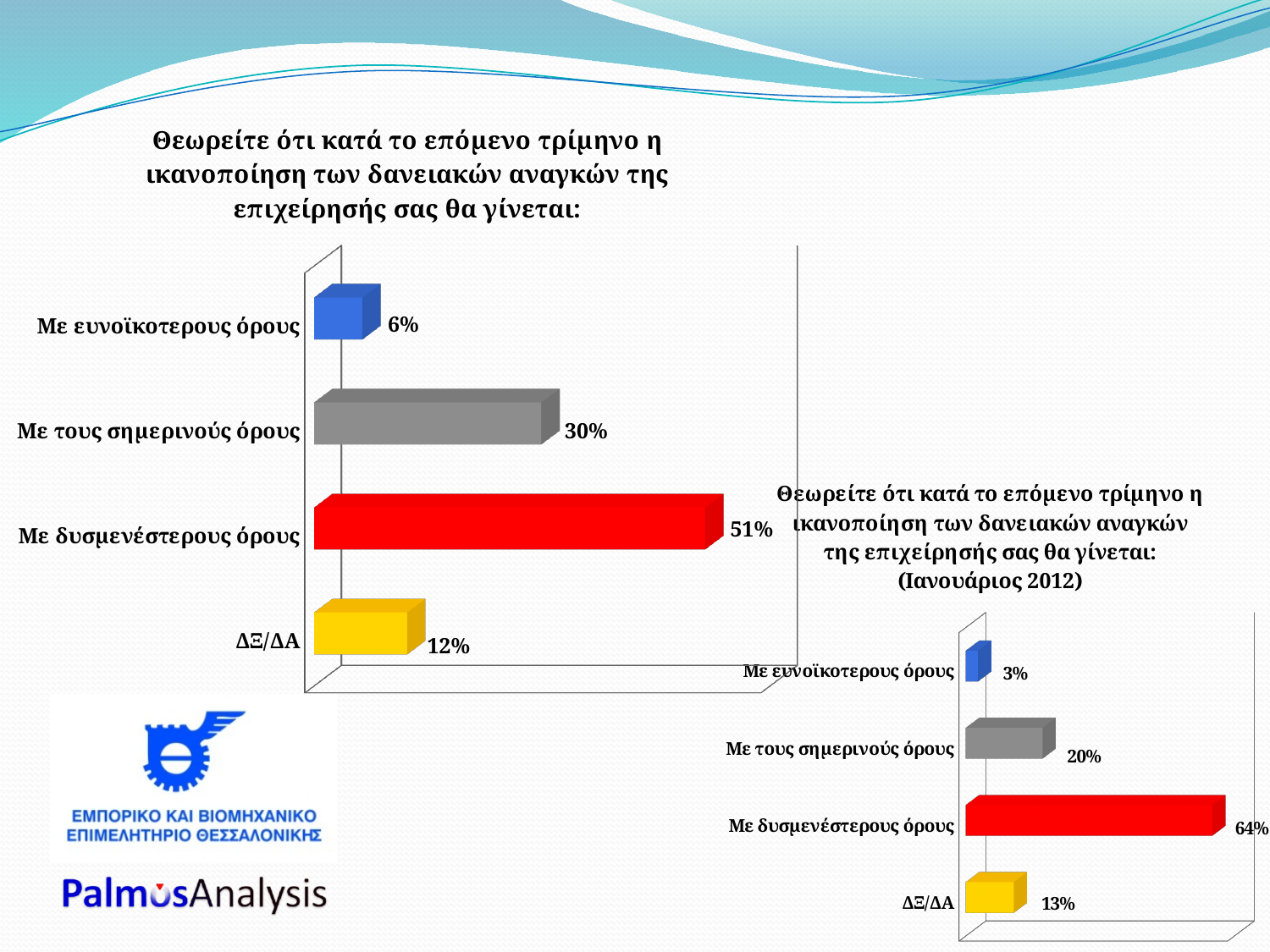
In the lower-right chart (Ιανουάριος 2012), what is the value for 'ΔΞ/ΔΑ'? 13% In the upper-left chart, what is the difference between 'Με δυσμενέστερους όρους' and 'Με τους σημερινούς όρους'? 21% What kind of chart is the lower-right chart (Ιανουάριος 2012)? Bar chart In the upper-left chart, which category has the highest value? Με δυσμενέστερους όρους In the upper-left chart, which category has the lowest value? Με ευνοϊκοτερους όρους In the upper-left chart, what is the value for 'Με τους σημερινούς όρους'? 30% In the lower-right chart (Ιανουάριος 2012), what is the value for 'Με ευνοϊκοτερους όρους'? 3% Which is larger: 'Με δυσμενέστερους όρους' in the upper-left chart or in the lower-right chart (Ιανουάριος 2012)? Lower-right chart (Ιανουάριος 2012) In the upper-left chart, what is the value for 'Με δυσμενέστερους όρους'? 51% How many categories does the upper-left chart show? 4 In the lower-right chart (Ιανουάριος 2012), what is the difference between 'Με δυσμενέστερους όρους' and 'Με τους σημερινούς όρους'? 44% In the lower-right chart (Ιανουάριος 2012), which category has the highest value? Με δυσμενέστερους όρους